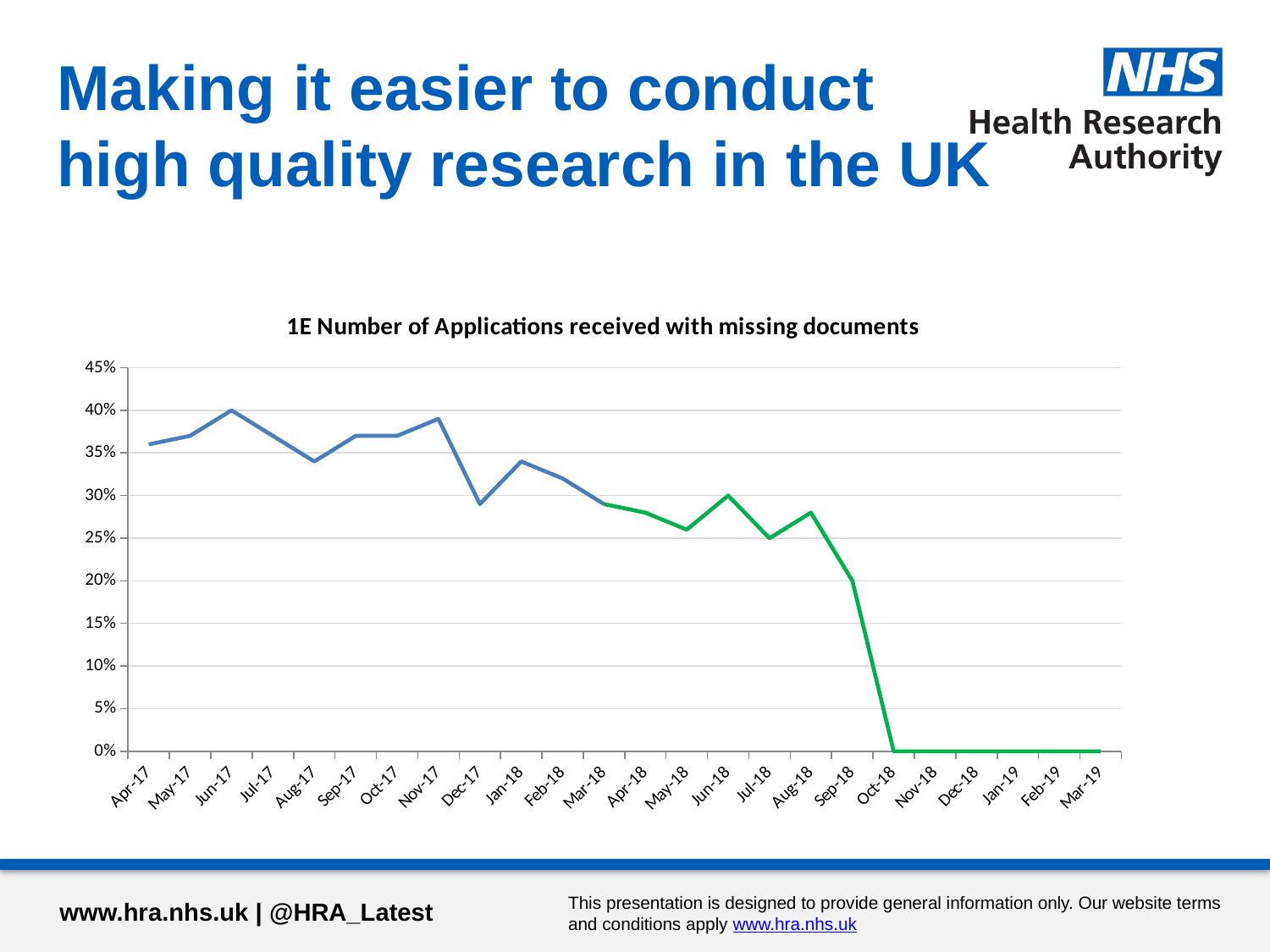
What is the lowest value shown on the chart? 0% Do the values generally rise or fall from Apr-17 to Mar-19? Fall What kind of chart is shown on the slide? Line chart What is the value for Sep-18? 20% How many months are plotted along the x axis? 24 What is the value for Jan-19? 0% What is the value for Jun-17? 40% What is the value for Jul-18? 25% Is the value for Apr-18 greater or less than 30%? less Is the value for Apr-17 greater or less than 35%? greater What is the title of the chart? 1E Number of Applications received with missing documents Which is larger, the value for Jun-18 or the value for Jul-18? Jun-18